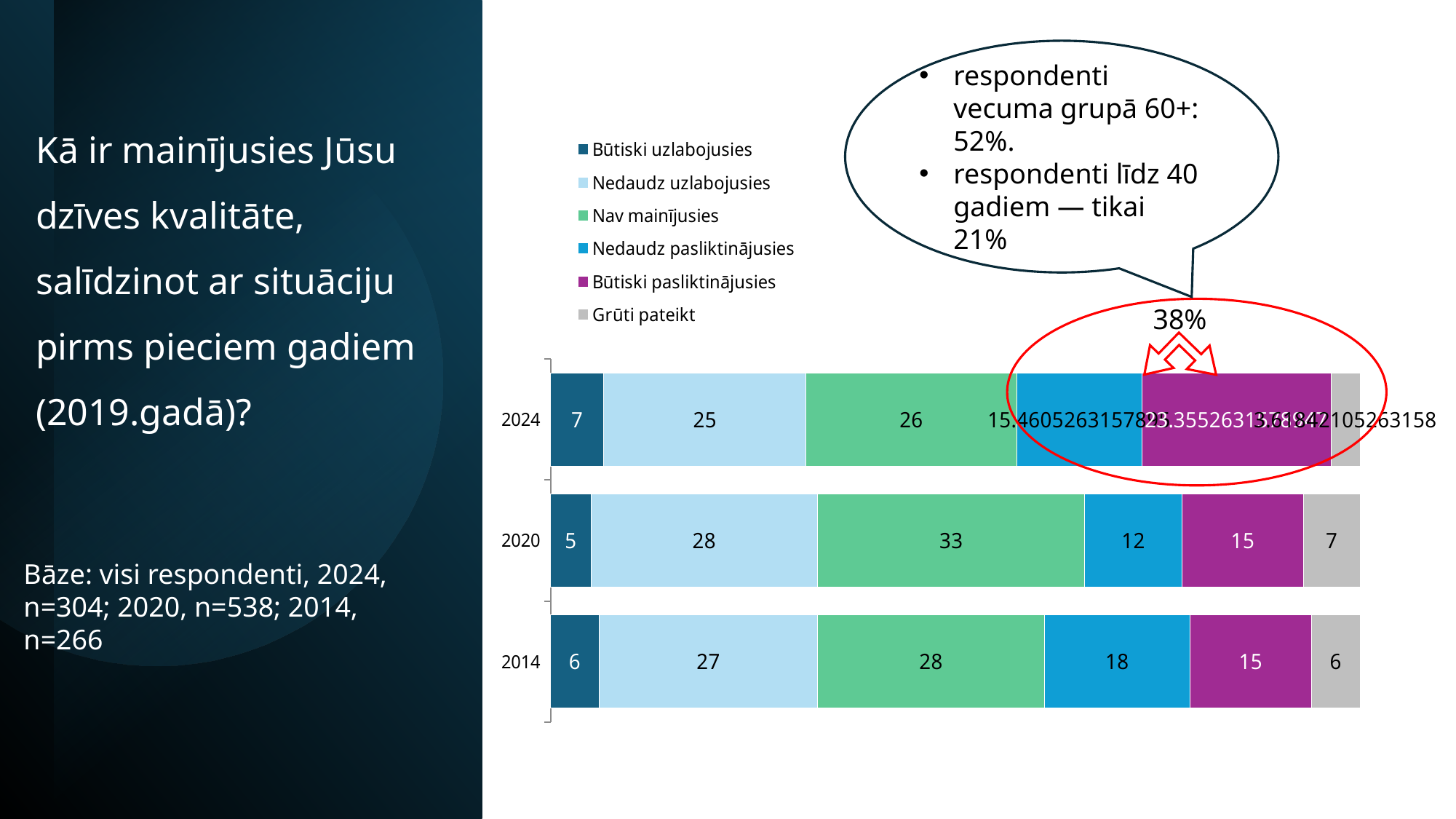
What is the value for "Grūti pateikt" in 2014? 6 Which year has the larger "Nedaudz pasliktinājusies" value, 2014 or 2020? 2014 What is the total of the stacked bar for 2020? 100 What is the value for "Nedaudz pasliktinājusies" in 2014? 18 What kind of chart is shown on the slide? Stacked bar chart How many series does the legend list? 6 How many years (categories) are plotted in the chart? 3 What is the value for "Nav mainījusies" in 2020? 33 What is the value for "Nedaudz uzlabojusies" in 2024? 25 What is the difference between the "Nav mainījusies" values for 2020 and 2014? 5 In which year is the "Nav mainījusies" value highest? 2020 What is the value for "Būtiski uzlabojusies" in 2020? 5